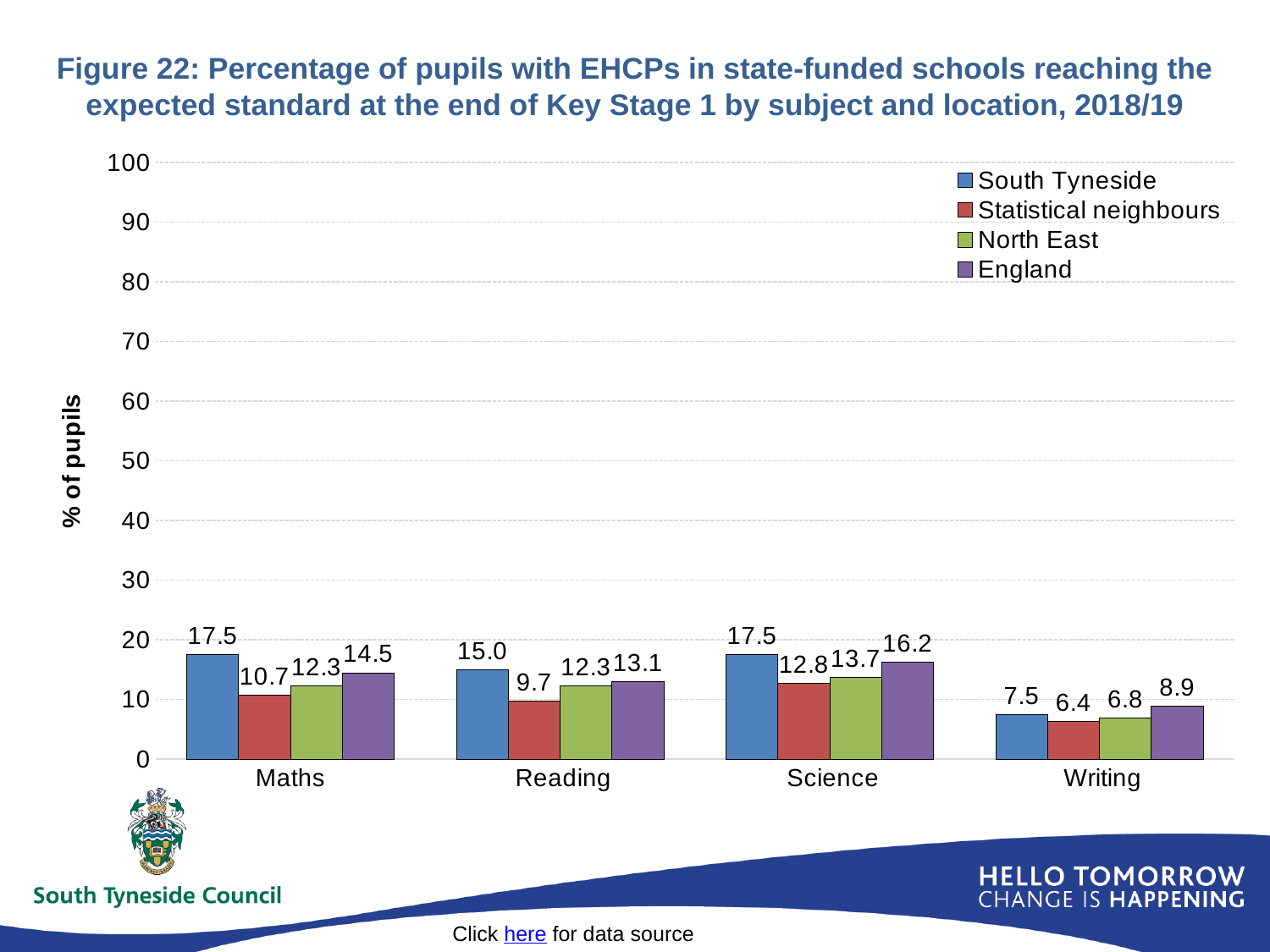
What is the value for South Tyneside in Maths? 17.5 What is the value for England in Science? 16.2 Which subject has the lowest value for South Tyneside? Writing What is the label on the y axis? % of pupils What kind of chart is shown on the slide? Bar chart How many series does the legend list? 4 How many subjects are shown on the x axis? 4 Which location has the highest value in Reading? South Tyneside What is the difference between South Tyneside and Statistical neighbours in Maths? 6.8 Which is larger in Writing: England or North East? England What is the value for Statistical neighbours in Reading? 9.7 What is the value for North East in Writing? 6.8